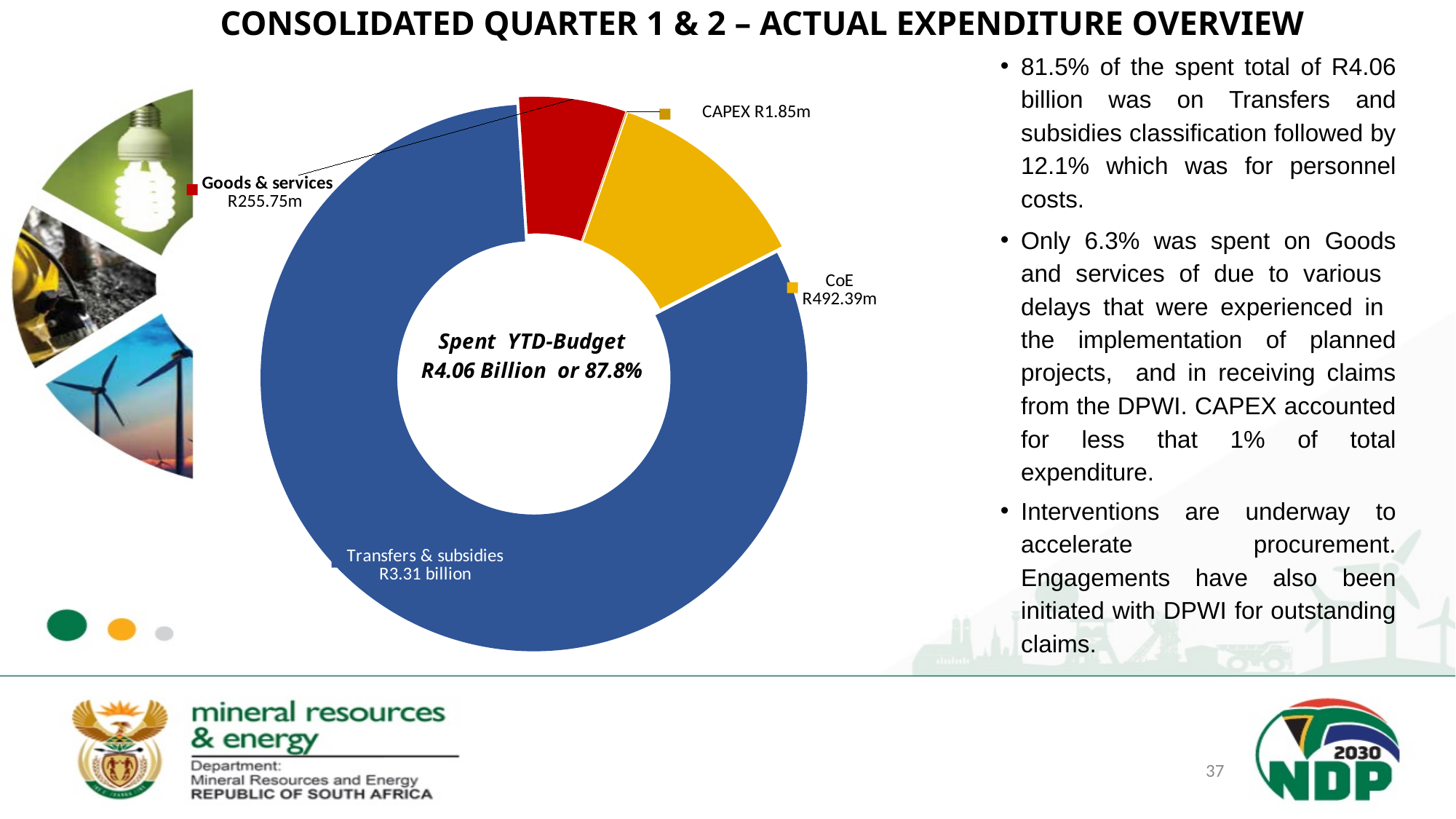
What kind of chart is shown on the slide? Pie (donut) chart What is the value shown for CoE in the chart? R492.39m How many categories are shown in the chart? 4 Which category has the smallest slice in the chart? CAPEX What colour is the Transfers & subsidies slice? Blue Which category has the largest slice in the chart? Transfers & subsidies What is the value shown for Goods & services in the chart? R255.75m What is the value shown for CAPEX in the chart? R1.85m What total spent amount is written in the centre of the chart? R4.06 Billion or 87.8% Which is larger, CoE or Goods & services? CoE What is the difference between the CoE value and the Goods & services value? R236.64m What is the value shown for Transfers & subsidies in the chart? R3.31 billion